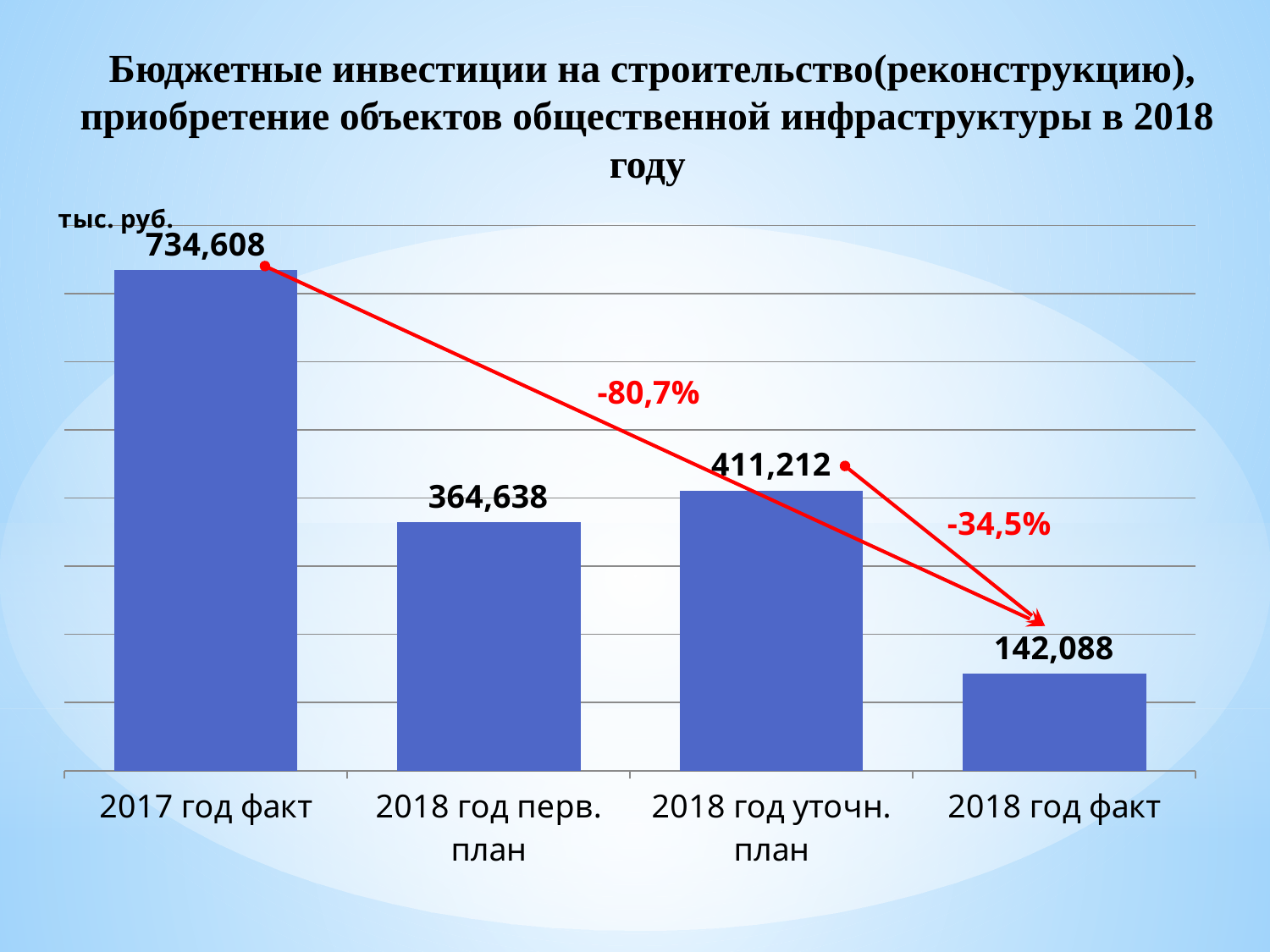
What is the difference between the values for 2018 год уточн. план and 2018 год перв. план? 46,574 What kind of chart is shown on the slide? bar chart What unit of measurement is indicated on the chart? тыс. руб. What is the value for 2018 год факт? 142,088 Which category has the highest value? 2017 год факт Which category has the lowest value? 2018 год факт What is the value for 2017 год факт? 734,608 What is the value for 2018 год перв. план? 364,638 What is the value for 2018 год уточн. план? 411,212 How many categories are shown on the chart? 4 What is the difference between the values for 2017 год факт and 2018 год факт? 592,520 Which is larger, the value for 2018 год перв. план or 2018 год уточн. план? 2018 год уточн. план